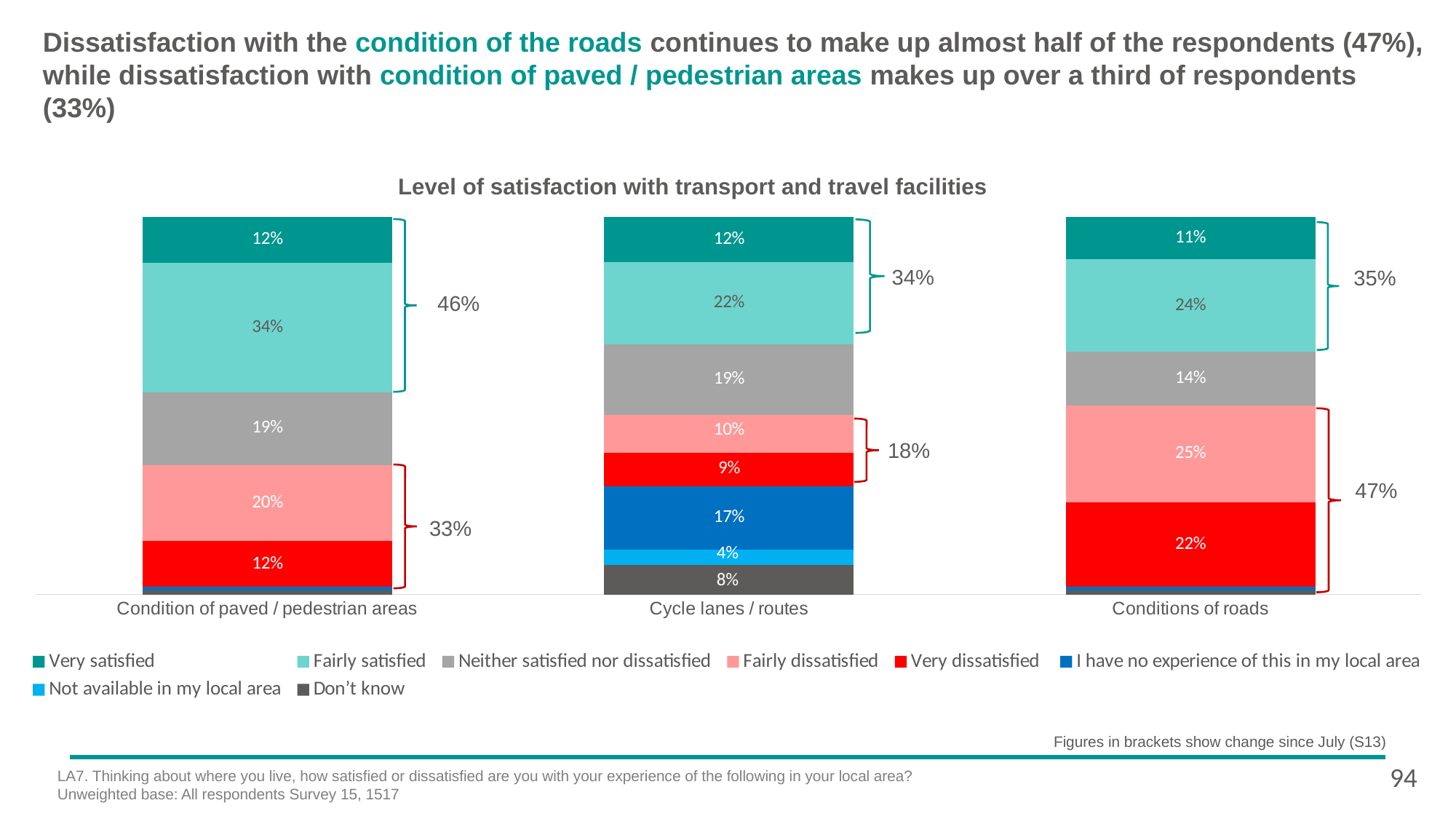
What is the 'Not available in my local area' value for Cycle lanes / routes? 4% What is the 'Very dissatisfied' value for Conditions of roads? 22% What is the 'Neither satisfied nor dissatisfied' value for Condition of paved / pedestrian areas? 19% Which category has the highest 'Fairly dissatisfied' value? Conditions of roads How many series does the chart's legend list? 8 What is the title of the chart? Level of satisfaction with transport and travel facilities How many categories are shown along the x axis of the chart? 3 What kind of chart is shown on the slide? Stacked bar chart What is the 'Fairly satisfied' value for Cycle lanes / routes? 22% Which category has the lowest 'Very satisfied' value? Conditions of roads Which has the larger 'Very dissatisfied' value: Condition of paved / pedestrian areas or Cycle lanes / routes? Condition of paved / pedestrian areas What is the difference between the 'Fairly satisfied' values for Condition of paved / pedestrian areas and Conditions of roads? 10 percentage points